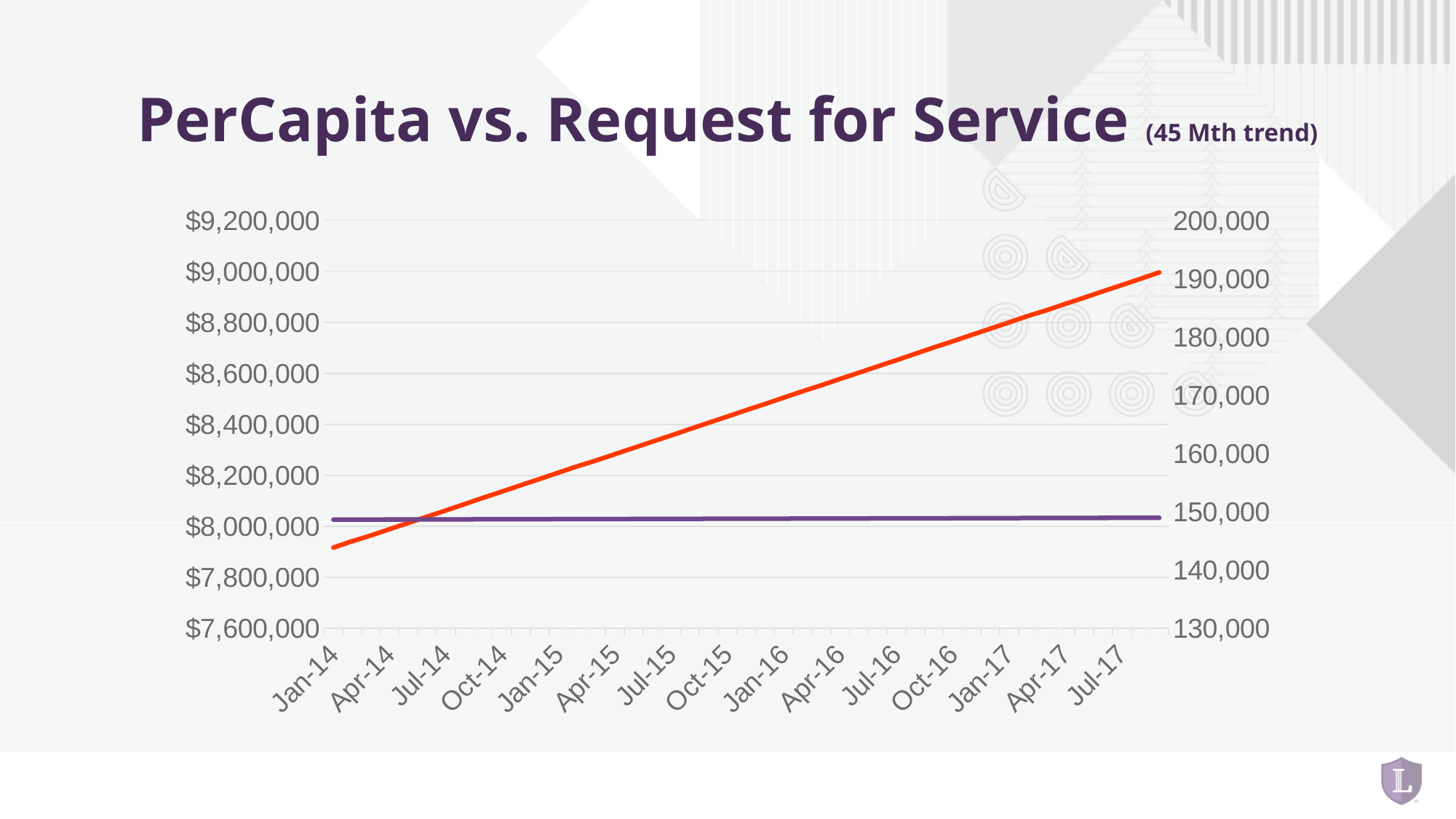
Read against the right axis, is the red line at Jul-17 greater or less than 180,000? greater Read against the left axis, is the red line at Jul-17 greater or less than $8,800,000? greater What kind of chart is shown on the slide? line chart Read against the left axis, is the red line at Jan-14 greater or less than $8,000,000? less Does the purple line rise, fall, or stay roughly flat from Jan-14 to Jul-17? stay roughly flat How many lines are plotted on the chart? 2 What is the title of the chart? PerCapita vs. Request for Service (45 Mth trend) How many date labels are shown along the x axis? 15 At Jan-14, which line is plotted higher on the chart, the red line or the purple line? the purple line Does the red line rise or fall from Jan-14 to Jul-17? rise At Jul-17, which line is plotted higher on the chart, the red line or the purple line? the red line What is the first date label on the x axis? Jan-14